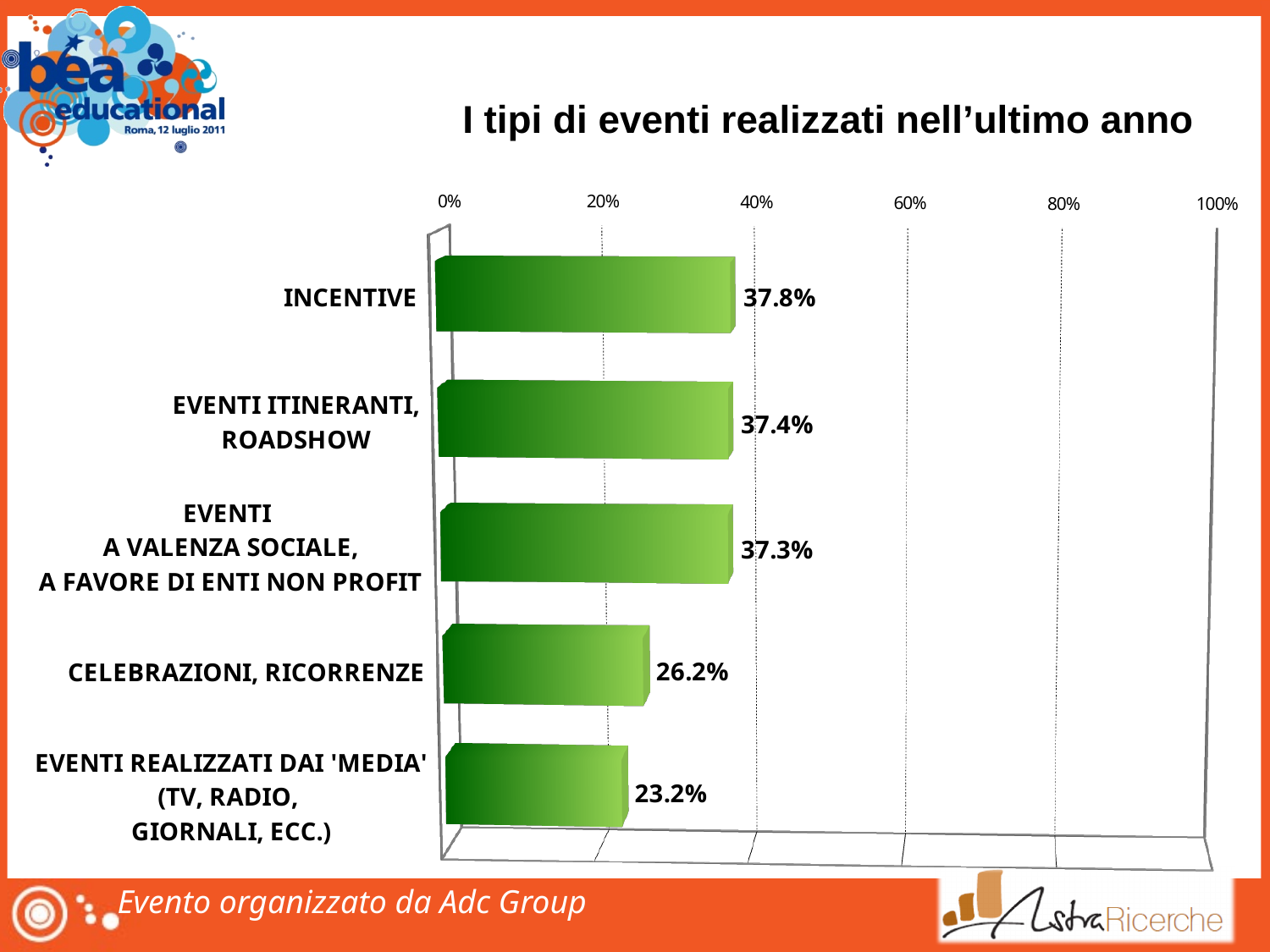
What is the difference between the values for CELEBRAZIONI, RICORRENZE and EVENTI REALIZZATI DAI 'MEDIA' (TV, RADIO, GIORNALI, ECC.)? 3.0% What is the value for EVENTI ITINERANTI, ROADSHOW? 37.4% Which is larger, the value for EVENTI A VALENZA SOCIALE, A FAVORE DI ENTI NON PROFIT or the value for CELEBRAZIONI, RICORRENZE? EVENTI A VALENZA SOCIALE, A FAVORE DI ENTI NON PROFIT What is the value for EVENTI REALIZZATI DAI 'MEDIA' (TV, RADIO, GIORNALI, ECC.)? 23.2% How many categories are shown in the chart? 5 What is the value for INCENTIVE? 37.8% What is the title of the chart? I tipi di eventi realizzati nell'ultimo anno What kind of chart is shown on the slide? bar chart Which category has the lowest value? EVENTI REALIZZATI DAI 'MEDIA' (TV, RADIO, GIORNALI, ECC.) Is the value for INCENTIVE greater or less than 40%? less What is the value for CELEBRAZIONI, RICORRENZE? 26.2% What is the difference between the values for INCENTIVE and CELEBRAZIONI, RICORRENZE? 11.6%